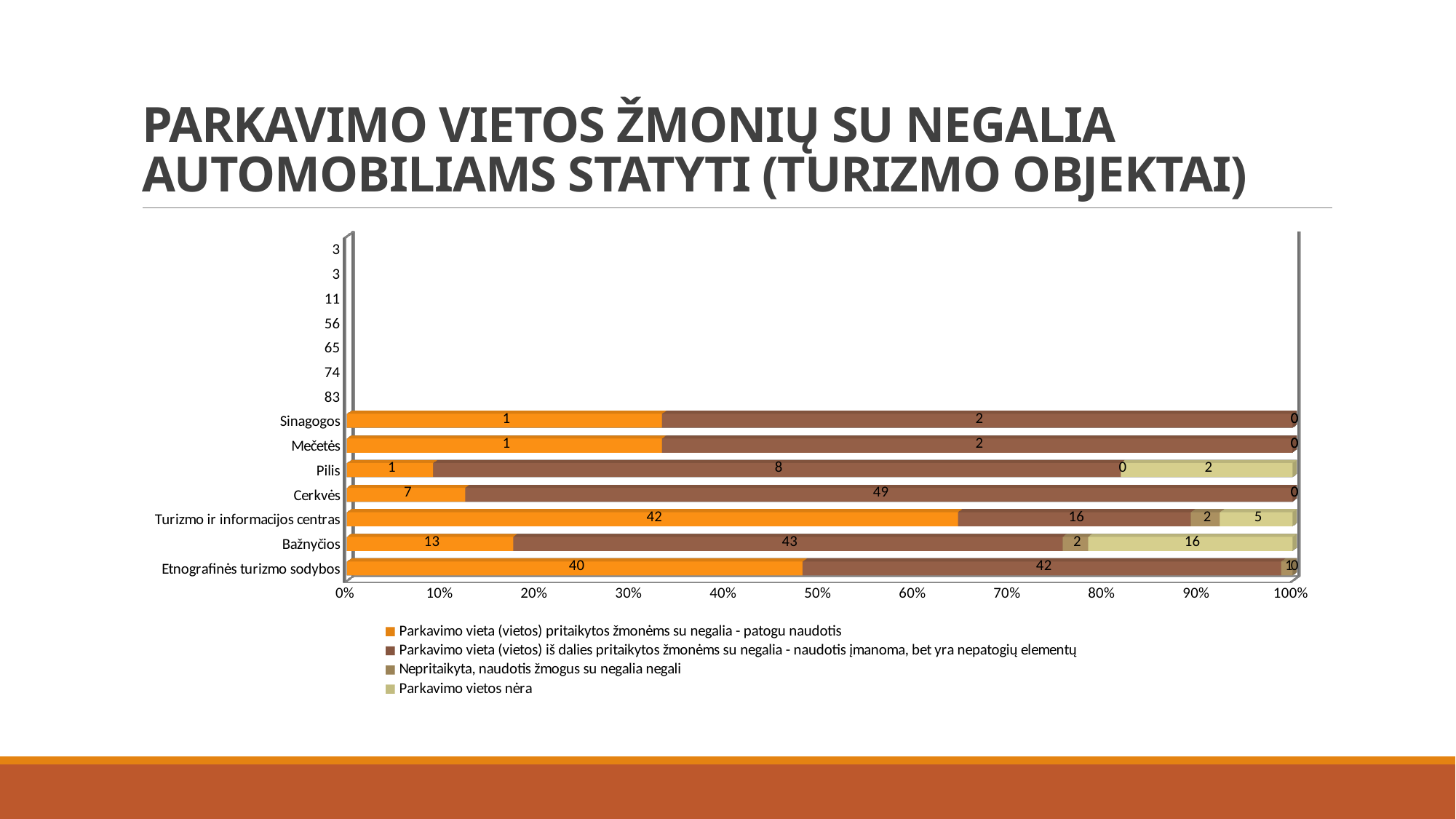
What kind of chart is shown on the slide? Stacked bar chart For Bažnyčios, what is the difference between the 'iš dalies pritaikytos' value and the 'patogu naudotis' value? 30 What is the value of the 'Parkavimo vietos nėra' series for Bažnyčios? 16 What is the value of the 'Parkavimo vieta (vietos) iš dalies pritaikytos žmonėms su negalia' series for Cerkvės? 49 What is the total of all values in the Turizmo ir informacijos centras bar? 65 Which has the larger 'iš dalies pritaikytos' value, Cerkvės or Bažnyčios? Cerkvės What is the value of the 'Parkavimo vieta (vietos) iš dalies pritaikytos žmonėms su negalia' series for Pilis? 8 Is the share of the 'patogu naudotis' segment for Cerkvės greater or less than 20%? less How many series does the legend list? 4 What colour represents the 'Parkavimo vieta (vietos) pritaikytos žmonėms su negalia - patogu naudotis' series? Orange Which category has the highest value in the 'Parkavimo vieta (vietos) pritaikytos žmonėms su negalia - patogu naudotis' series? Turizmo ir informacijos centras What is the value of the 'Parkavimo vieta (vietos) pritaikytos žmonėms su negalia - patogu naudotis' series for Turizmo ir informacijos centras? 42